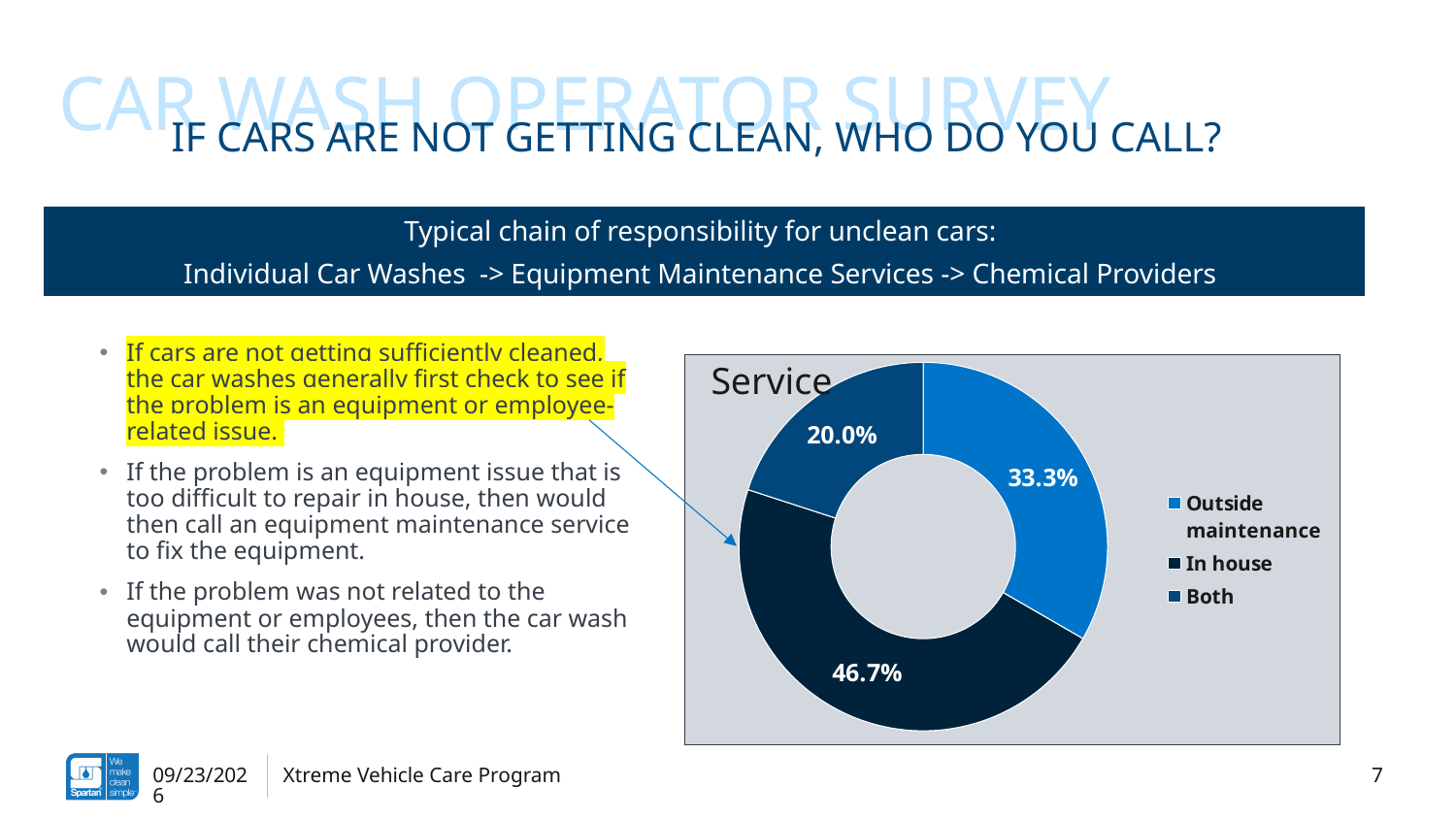
Which category has the largest share of the chart? In house What is the difference in percentage points between the Outside maintenance share and the Both share? 13.3 What is the title of the chart? Service What percentage of the chart is labelled for Both? 20.0% What is the difference in percentage points between the In house share and the Outside maintenance share? 13.4 Which is larger, the share for Outside maintenance or the share for Both? Outside maintenance Which category has the smallest share of the chart? Both Which legend entry is listed first in the chart legend? Outside maintenance How many categories does the chart legend list? 3 What percentage of the chart is labelled for Outside maintenance? 33.3% What percentage of the chart is labelled for In house? 46.7% What kind of chart is shown on the slide? Doughnut chart